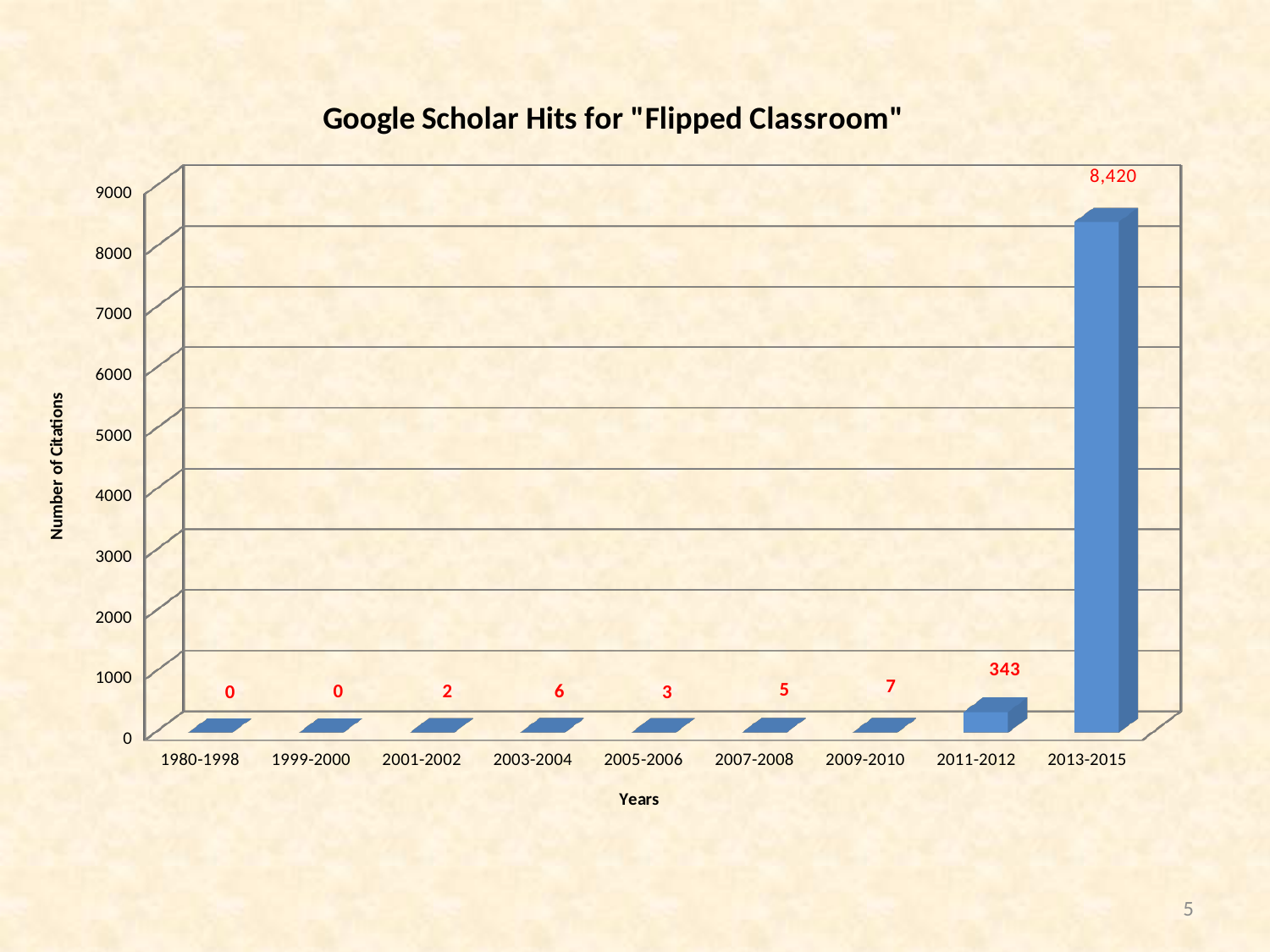
What is the title of the chart? Google Scholar Hits for "Flipped Classroom" What is the difference in citations between 2013-2015 and 2011-2012? 8,077 What is the number of citations for 2013-2015? 8,420 Which period has the highest number of citations? 2013-2015 What is the number of citations for 2009-2010? 7 What kind of chart is shown on the slide? Bar chart What is the number of citations for 2003-2004? 6 Is the value for 2013-2015 greater or less than 8000? greater How many year periods are shown on the x axis? 9 What is the number of citations for 2011-2012? 343 Do the citation values generally rise or fall from 1980-1998 to 2013-2015? Rise Which has more citations, 2007-2008 or 2005-2006? 2007-2008